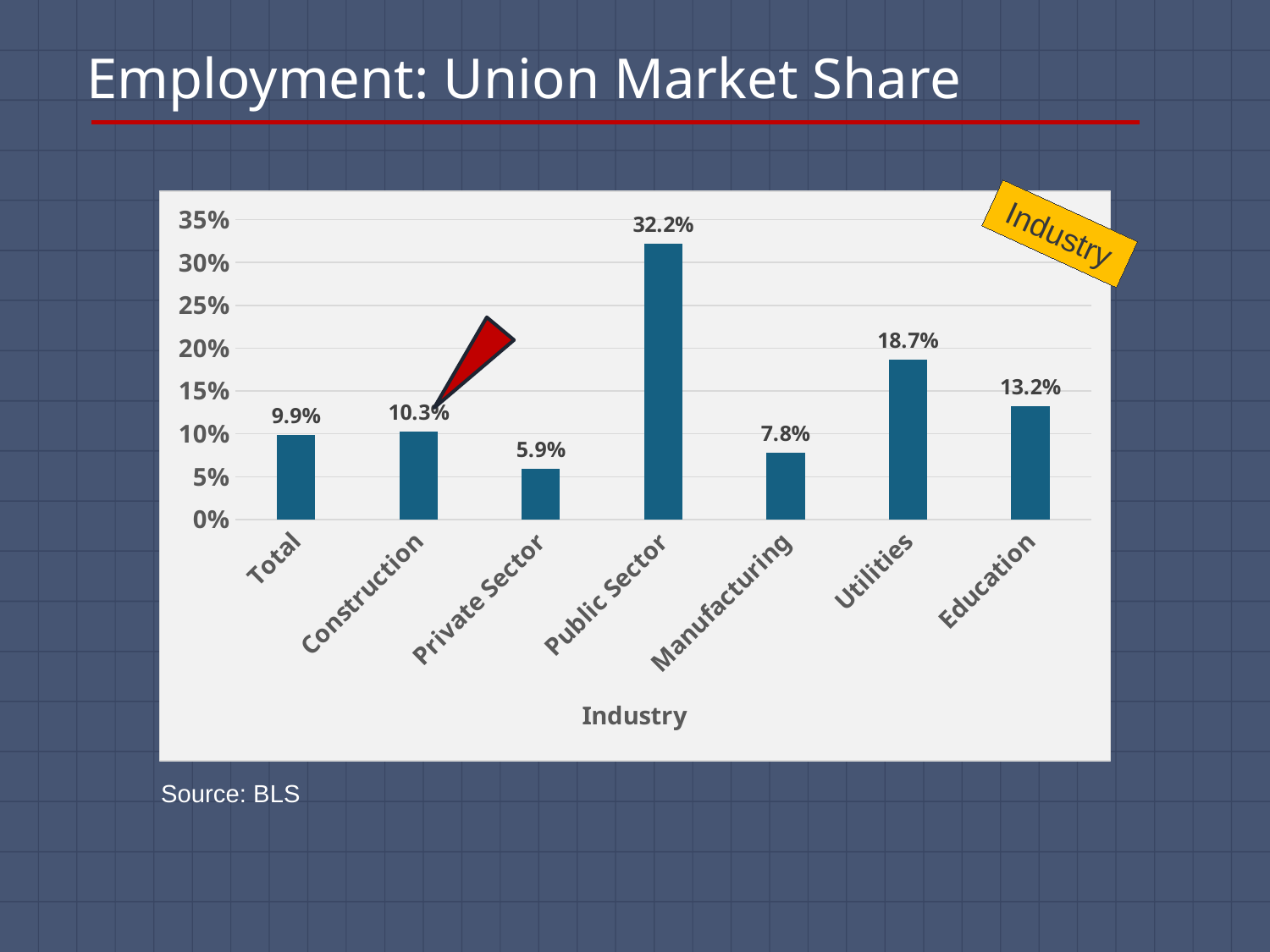
What is the label on the x axis of the chart? Industry What is the difference between the union market share of the Public Sector and the Private Sector? 26.3% What is the union market share for the Public Sector? 32.2% How many industry categories are shown on the chart? 7 Is the value for Education greater or less than 10%? greater Which industry has the lowest union market share? Private Sector Which industry has the highest union market share? Public Sector Which has a larger union market share, Utilities or Education? Utilities What is the union market share for Construction? 10.3% What kind of chart is shown on the slide? Bar chart What is the union market share for Manufacturing? 7.8% What is the union market share for Utilities? 18.7%